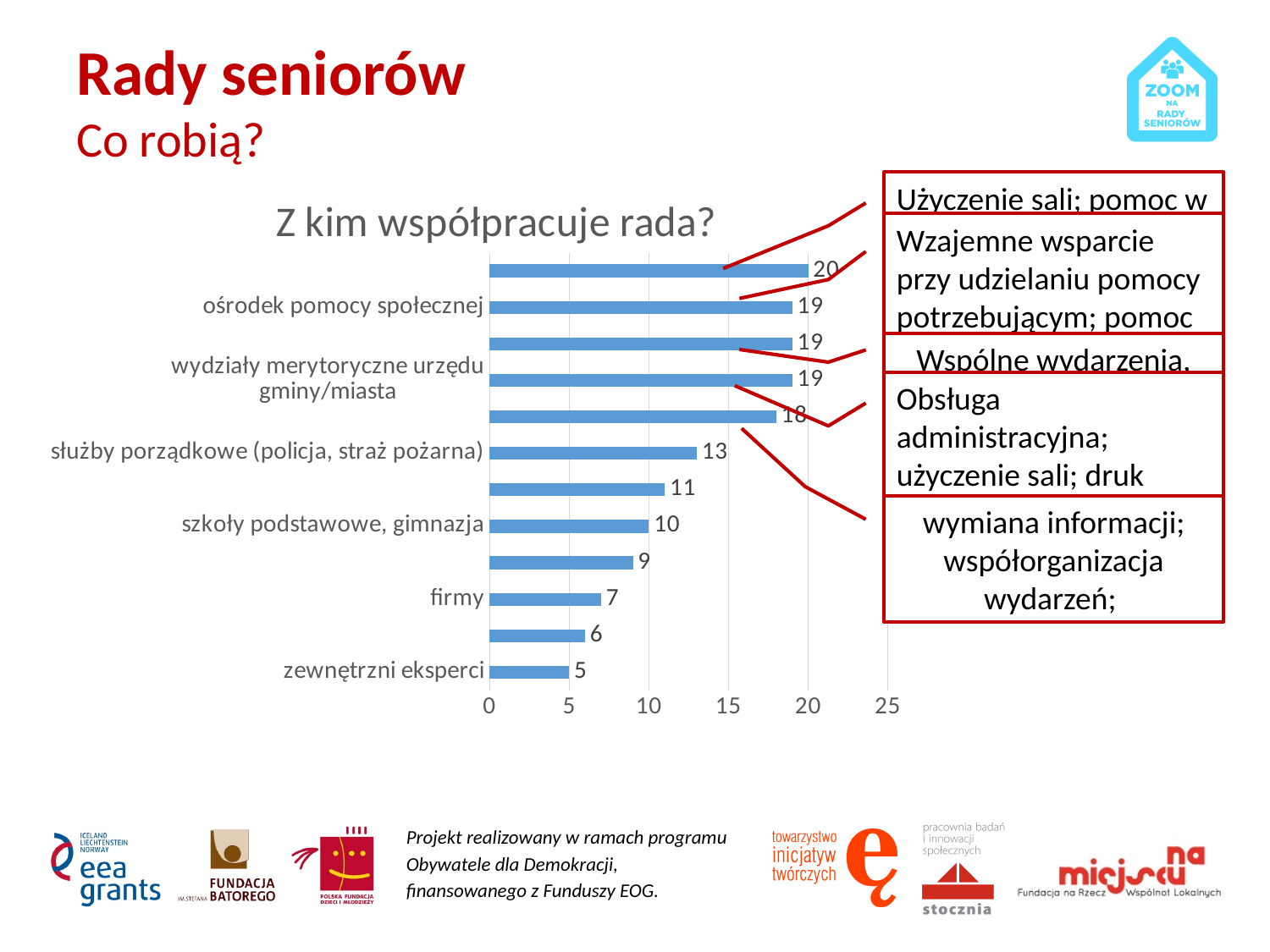
What is the value for służby porządkowe (policja, straż pożarna)? 13 What is the value for firmy? 7 What is the value for ośrodek pomocy społecznej? 19 What is the difference between the values for ośrodek pomocy społecznej and firmy? 12 Which is larger, the value for służby porządkowe (policja, straż pożarna) or the value for szkoły podstawowe, gimnazja? służby porządkowe (policja, straż pożarna) What is the title of the chart? Z kim współpracuje rada? Which labelled category has the lowest value? zewnętrzni eksperci What type of chart is shown on the slide? bar chart How many bars are plotted in the chart? 12 What is the highest value shown on any bar in the chart? 20 What is the value for zewnętrzni eksperci? 5 What is the value for szkoły podstawowe, gimnazja? 10